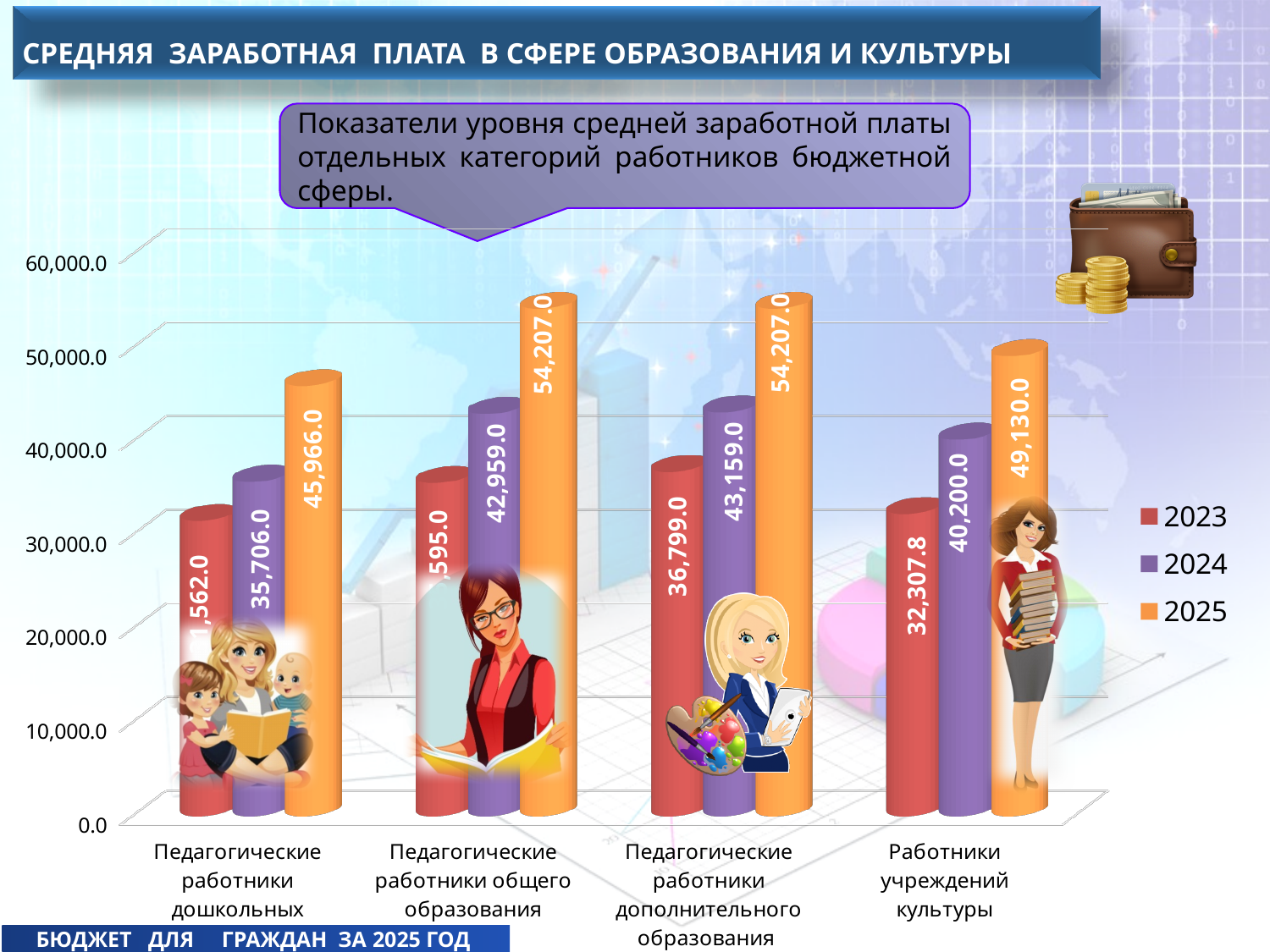
Is the 2025 value for Педагогические работники дошкольных greater or less than 50,000.0? less How many series does the legend list? 3 What kind of chart is shown on the slide? bar chart What is the 2024 value for Педагогические работники общего образования? 42,959.0 What is the 2023 value for Работники учреждений культуры? 32,307.8 What is the 2023 value for Педагогические работники дополнительного образования? 36,799.0 Which is larger: the 2024 value for Педагогические работники дошкольных or the 2024 value for Работники учреждений культуры? Работники учреждений культуры Which category has the lowest 2025 value? Педагогические работники дошкольных Which category has the highest 2024 value? Педагогические работники дополнительного образования What is the difference between the 2025 and 2024 values for Работники учреждений культуры? 8,930.0 How many categories are shown on the x axis? 4 What is the 2025 value for Работники учреждений культуры? 49,130.0